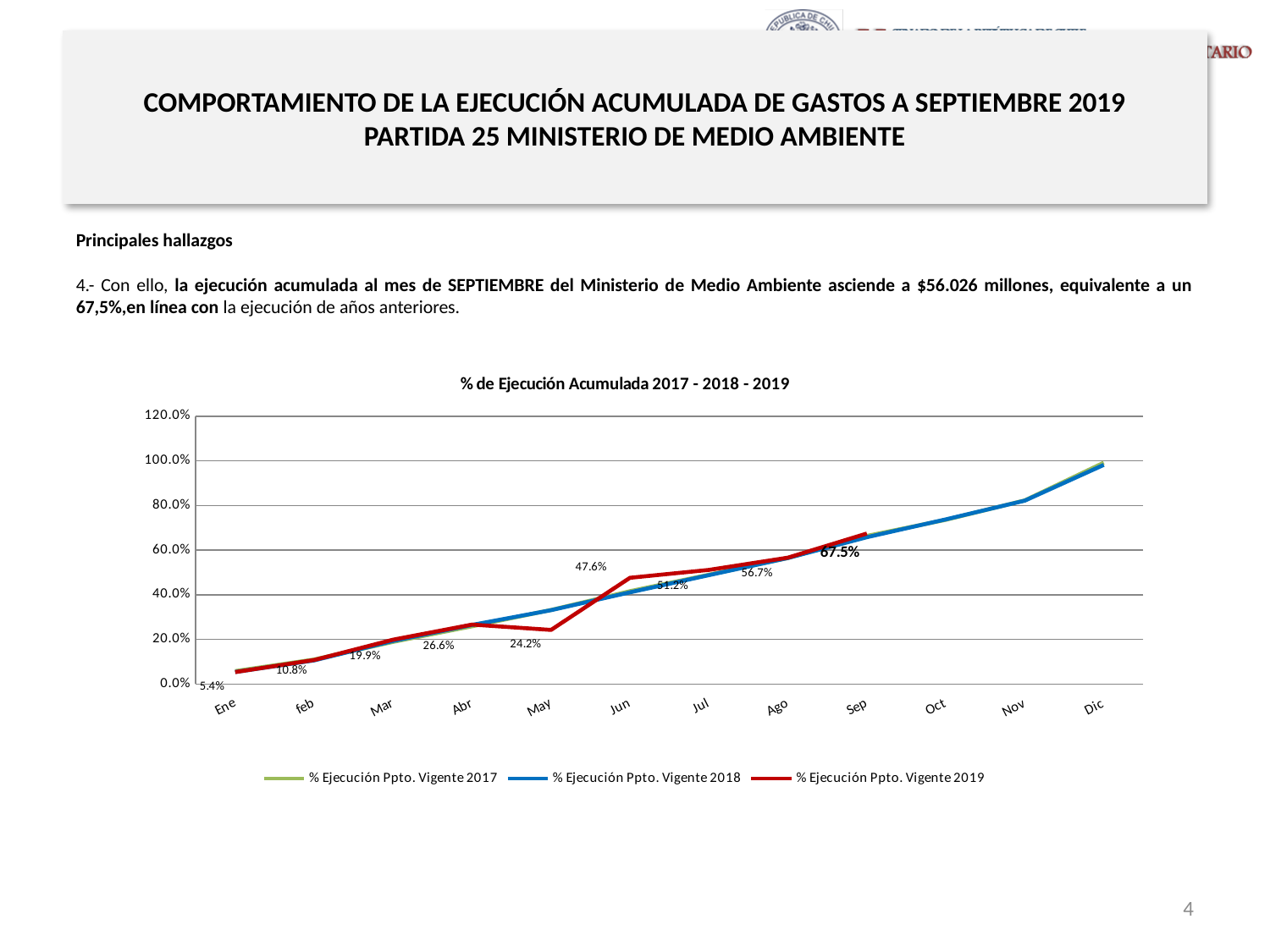
What is the value of % Ejecución Ppto. Vigente 2019 for Jun? 47.6% What is the value of % Ejecución Ppto. Vigente 2019 for Ene? 5.4% What is the value of % Ejecución Ppto. Vigente 2019 for May? 24.2% By how many percentage points does the 2019 series increase from May to Jun? 23.4 By how many percentage points does the 2019 series increase from Ago to Sep? 10.8 What is the value of % Ejecución Ppto. Vigente 2019 for Sep? 67.5% For the 2019 series, which is larger: the value for Abr or the value for May? Abr What kind of chart is shown? line chart How many series does the legend list? 3 Does the 2019 series rise or fall from Abr to May? fall How many months are shown on the x axis? 12 Is the value of % Ejecución Ppto. Vigente 2018 for Dic greater or less than 80.0%? greater